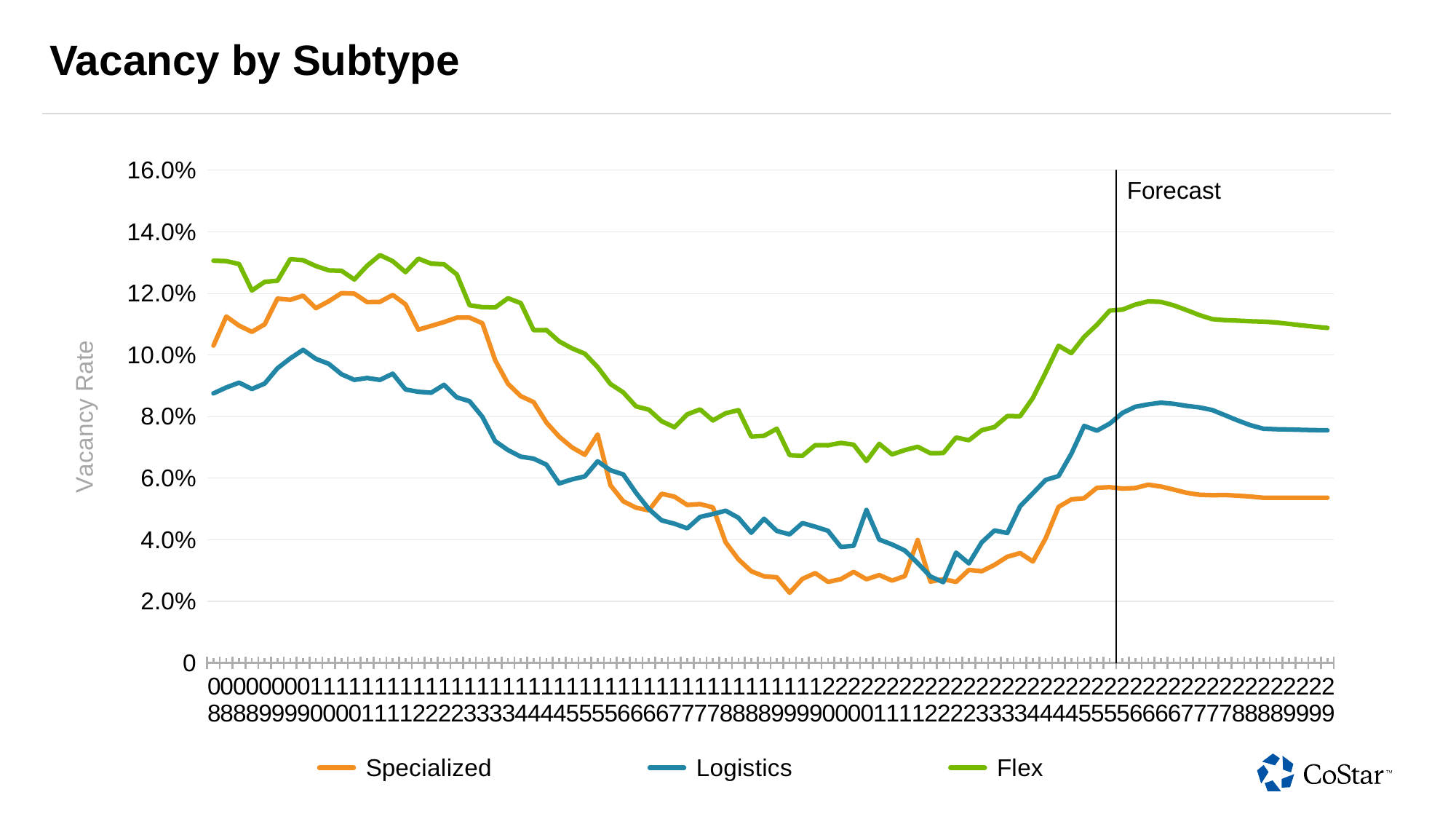
Which series has the lowest vacancy rate at the right end of the chart? Specialized What kind of chart is shown on the slide? line chart How many series does the legend list? 3 What does the vertical black line near the right side of the chart mark? Forecast What is the title of the chart? Vacancy by Subtype Is the Logistics value at the right end of the chart greater or less than 8.0%? less Is the Specialized value at the right end of the chart greater or less than 6.0%? less Which series reaches the highest vacancy rate anywhere on the chart? Flex Which series has the highest vacancy rate at the right end of the chart? Flex At the Forecast line, which is higher, Flex or Logistics? Flex Is the Flex value at the start of the chart greater or less than 12.0%? greater Does the Flex line rise or fall from the start of the chart to its lowest point near the middle? fall